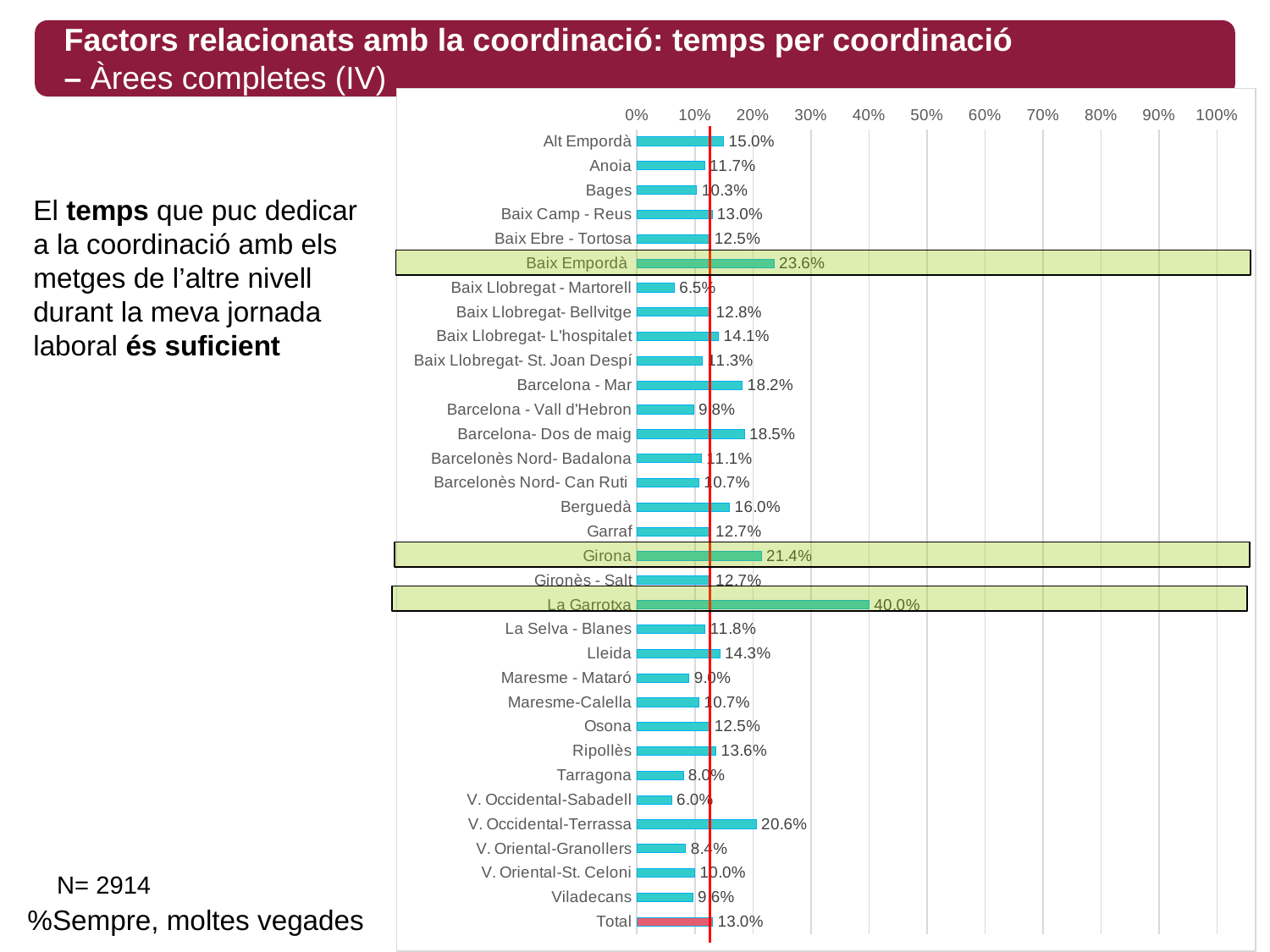
Which area has the highest value? La Garrotxa What is the difference between La Garrotxa and Total? 27.0 percentage points What is the value for La Garrotxa? 40.0% What kind of chart is shown on the slide? Bar chart Is the value for Tarragona greater or less than 10%? less How many bars are plotted in the chart, including Total? 33 Which is larger, Barcelona - Mar or Barcelona- Dos de maig? Barcelona- Dos de maig What is the value for Baix Empordà? 23.6% What is the value for Total? 13.0% Which area has the lowest value? V. Occidental-Sabadell What is the value for V. Occidental-Terrassa? 20.6% What is the difference between Baix Empordà and Girona? 2.2 percentage points